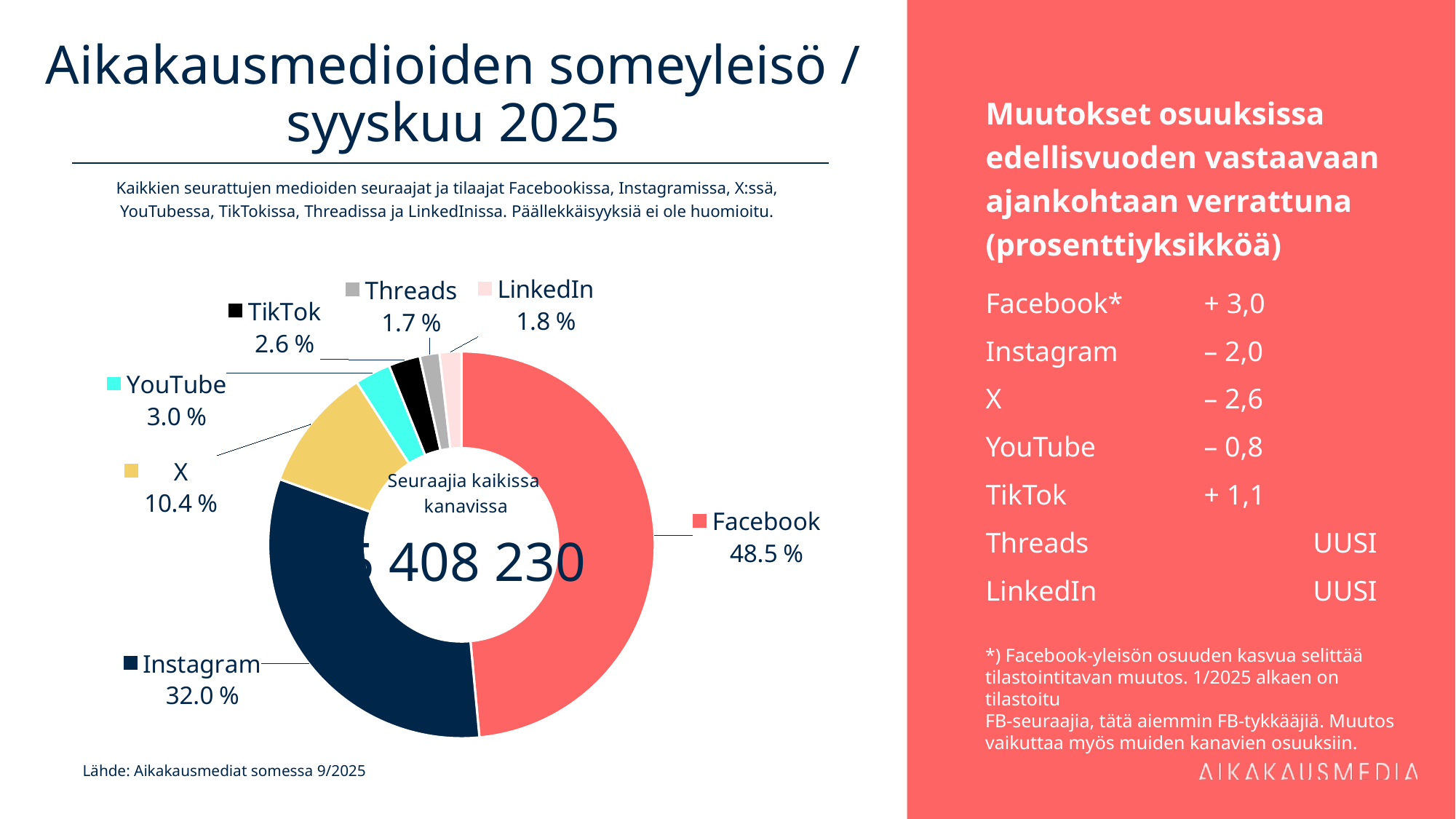
What share of the pie chart does Instagram hold? 32.0 % What type of chart is shown on the slide? Pie chart (donut) Which has a larger share, YouTube or TikTok? YouTube Which channel has the largest slice of the pie chart? Facebook Which has a larger share, LinkedIn or Threads? LinkedIn What is the value shown for X in the pie chart? 10.4 % How many channels are shown as slices in the pie chart? 7 Which channel has the smallest slice of the pie chart? Threads What share of the pie chart does Facebook hold? 48.5 % What is the difference in percentage points between Facebook's and Instagram's shares? 16.5 What text is written inside the centre of the donut chart above the number? Seuraajia kaikissa kanavissa What is the value shown for TikTok in the pie chart? 2.6 %